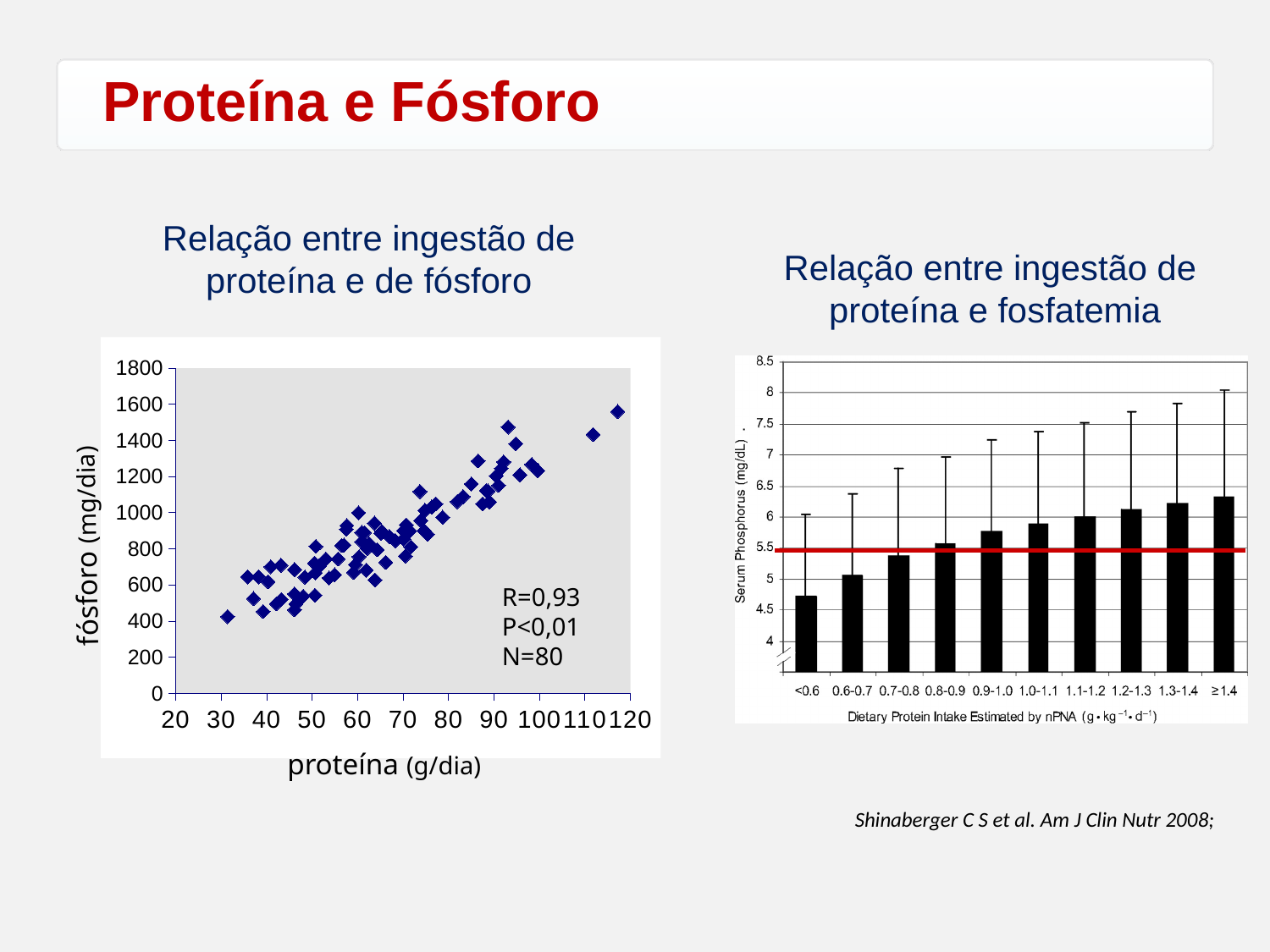
In the right chart, do the serum phosphorus bars rise or fall as dietary protein intake increases along the x axis? rise In the right chart, which dietary protein intake category has the highest serum phosphorus bar? ≥1.4 In the left chart, how many data points (N) does the annotation say are plotted? 80 In the right chart, is the serum phosphorus value for the 0.7-0.8 category greater or less than 5.5? less In the right chart, is the serum phosphorus value for the <0.6 category greater or less than 5? less In the right chart, is the serum phosphorus value for the ≥1.4 category greater or less than 6? greater What kind of chart is the left chart, 'Relação entre ingestão de proteína e de fósforo'? scatter plot What kind of chart is the right chart, 'Relação entre ingestão de proteína e fosfatemia'? bar chart In the left chart, do the fósforo values rise or fall as proteína increases along the x axis? rise How many categories of dietary protein intake are shown on the x axis of the right chart? 10 In the right chart, which dietary protein intake category has the lowest serum phosphorus bar? <0.6 In the left chart, what is the correlation coefficient R printed on the plot? R=0,93